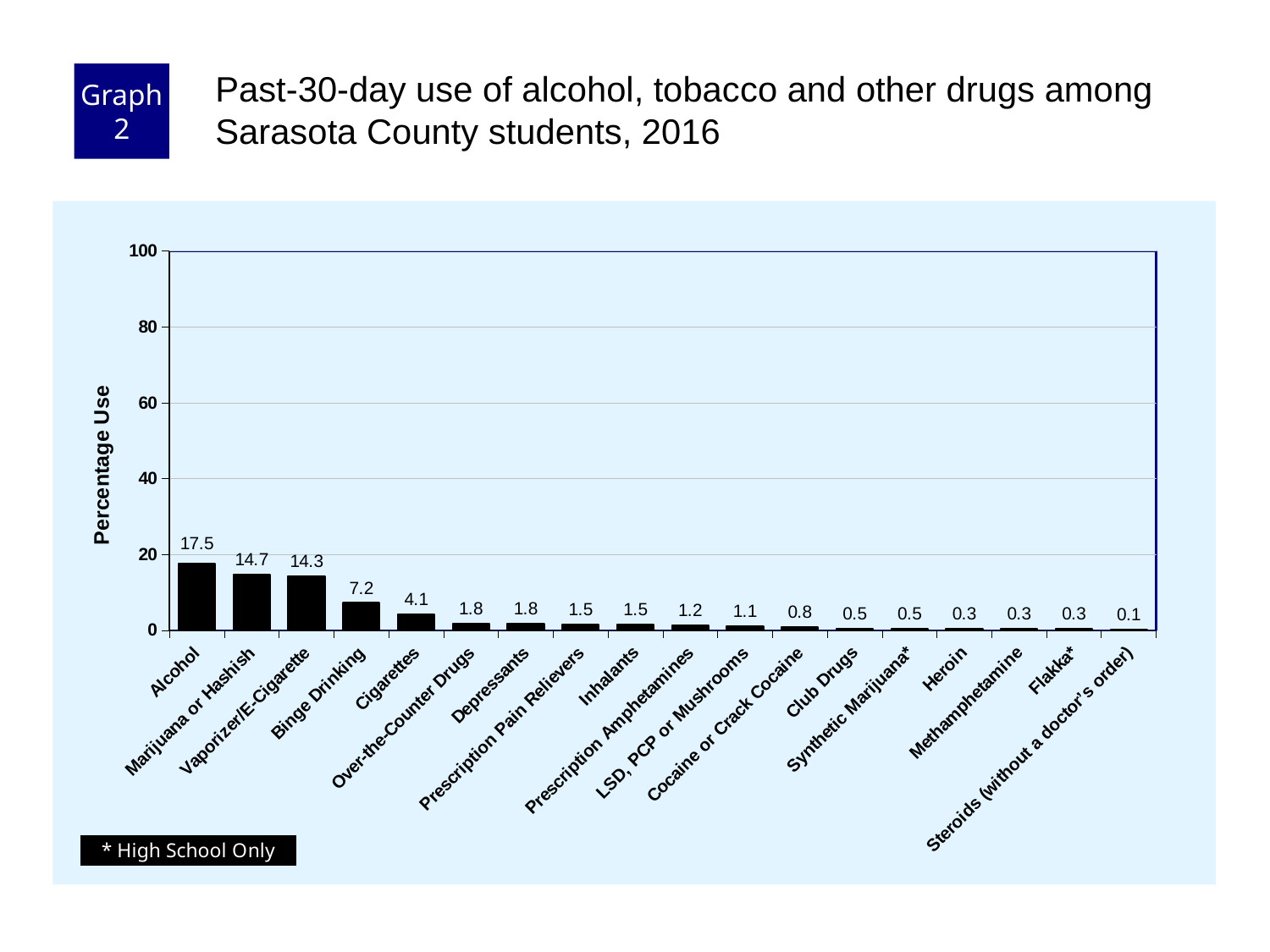
How many categories are shown on the x axis? 18 What is the difference in percentage use between Alcohol and Marijuana or Hashish? 2.8 What is the percentage use for Binge Drinking? 7.2 What kind of chart is shown on the slide? Bar chart Which category has the lowest percentage use? Steroids (without a doctor's order) What is the label of the y axis? Percentage Use What is the percentage use for Cocaine or Crack Cocaine? 0.8 What is the percentage use for Steroids (without a doctor's order)? 0.1 Is the value for Vaporizer/E-Cigarette greater or less than 20? less Which has a higher percentage use, Cigarettes or Binge Drinking? Binge Drinking What is the percentage use for Alcohol? 17.5 Which category has the highest percentage use? Alcohol